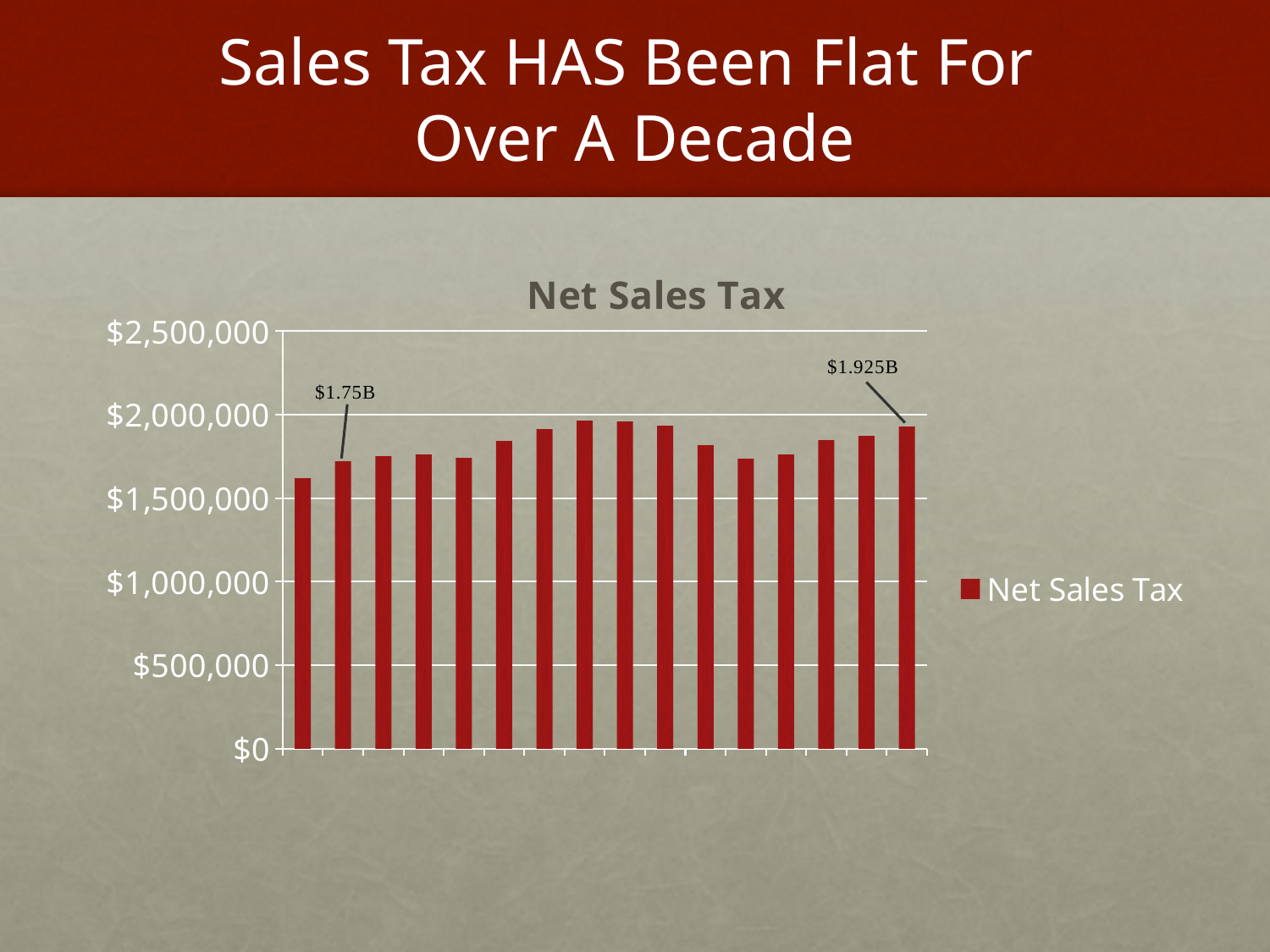
What is the title of the chart? Net Sales Tax What kind of chart is shown on the slide? bar chart Which bar has the lowest value, the leftmost bar or the rightmost bar? the leftmost bar Is the value of the leftmost bar greater or less than $2,000,000? less Which is larger, the value of the leftmost bar or the value of the rightmost bar? the rightmost bar Is the value of the leftmost bar greater or less than $1,500,000? greater How many bars are plotted in the chart? 16 How many series does the legend list? 1 What is the name of the series shown in the legend? Net Sales Tax Is the value of the rightmost bar greater or less than $2,000,000? less What value is annotated on the second bar from the left? $1.75B What value is annotated on the rightmost bar? $1.925B